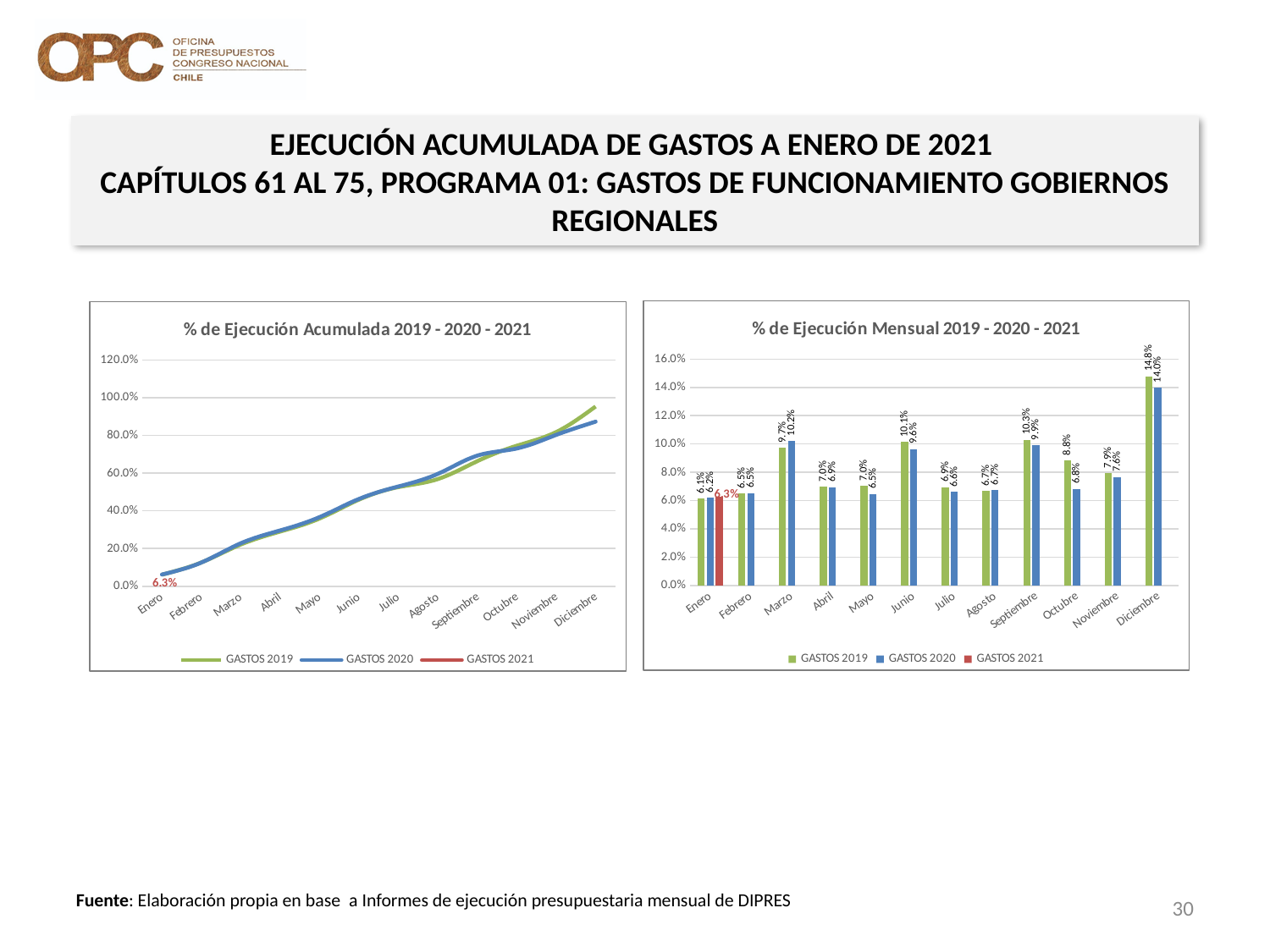
What kind of chart is the right-hand chart, '% de Ejecución Mensual 2019 - 2020 - 2021'? Bar chart In the '% de Ejecución Mensual' chart, which month has the highest value for GASTOS 2020? Diciembre In the '% de Ejecución Mensual' chart, which month has the lowest value for GASTOS 2019? Enero In the '% de Ejecución Mensual' chart, what is the value for GASTOS 2021 in Enero? 6.3% In the '% de Ejecución Mensual' chart, what is the value for GASTOS 2019 in Diciembre? 14.8% In the '% de Ejecución Acumulada' chart, do the GASTOS 2020 values rise or fall from Enero to Diciembre? Rise In the '% de Ejecución Mensual' chart, what is the difference between GASTOS 2019 and GASTOS 2020 in Octubre? 2.0 percentage points In the '% de Ejecución Acumulada' chart, is the value for GASTOS 2019 in Diciembre greater or less than 80%? greater How many months are shown on the x axis of the '% de Ejecución Mensual' chart? 12 How many series does the legend of the '% de Ejecución Mensual' chart list? 3 In the '% de Ejecución Mensual' chart, which is larger in Marzo: GASTOS 2019 or GASTOS 2020? GASTOS 2020 What kind of chart is the left-hand chart, '% de Ejecución Acumulada 2019 - 2020 - 2021'? Line chart